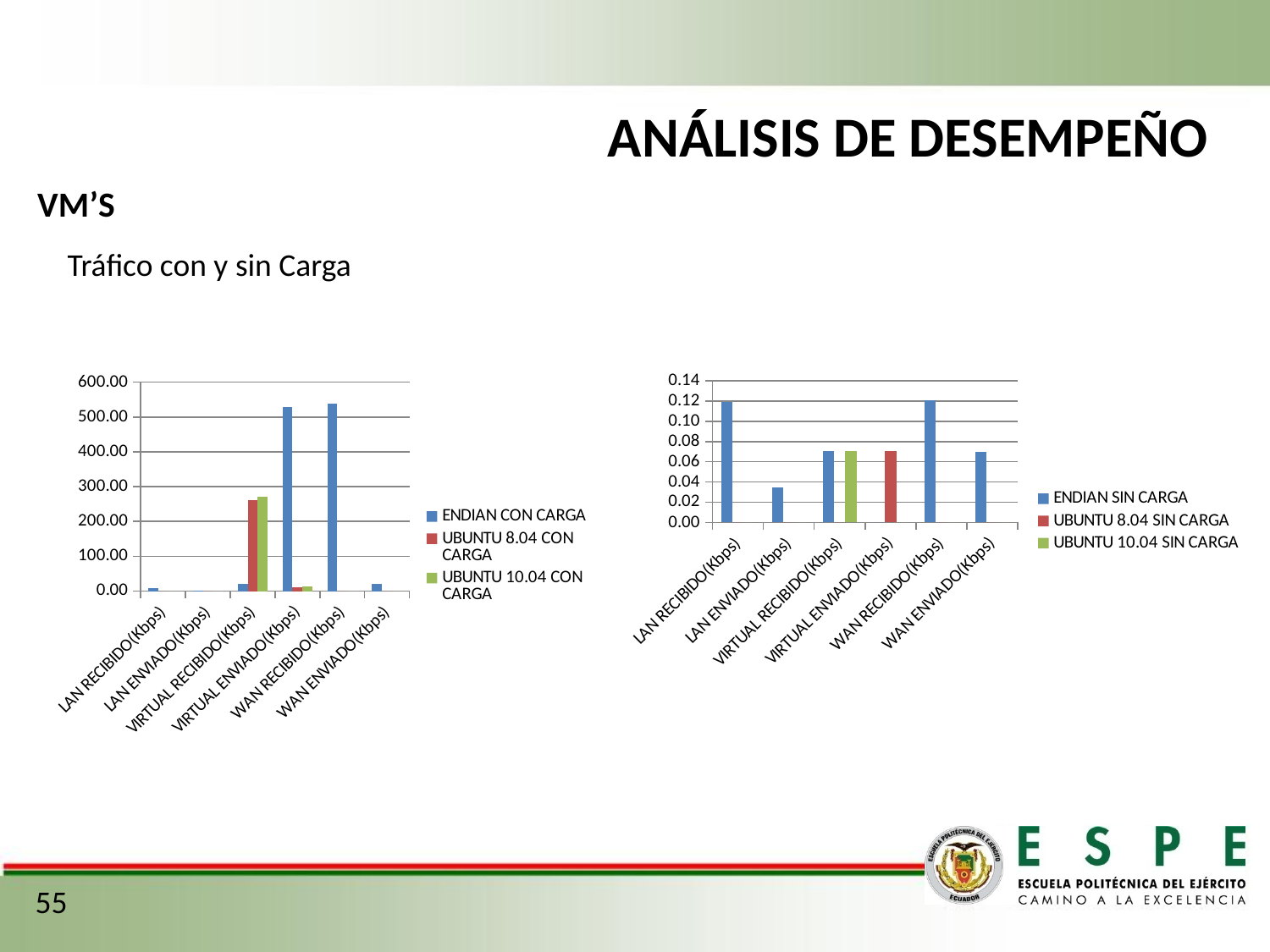
What kind of chart is the left chart on the slide? bar chart In the left chart, for VIRTUAL RECIBIDO(Kbps), which is larger: ENDIAN CON CARGA or UBUNTU 10.04 CON CARGA? UBUNTU 10.04 CON CARGA How many series does the legend of the right chart list? 3 In the right chart, is the UBUNTU 8.04 SIN CARGA value for VIRTUAL ENVIADO(Kbps) greater or less than 0.06? greater In the left chart, is the value of ENDIAN CON CARGA for WAN RECIBIDO(Kbps) greater or less than 500.00? greater In the right chart, which series is shown in green in the legend? UBUNTU 10.04 SIN CARGA In the left chart, which category has the highest ENDIAN CON CARGA value? WAN RECIBIDO(Kbps) How many categories are shown on the x axis of the left chart? 6 In the right chart, is the ENDIAN SIN CARGA value for LAN ENVIADO(Kbps) greater or less than 0.04? less In the right chart, which is larger for ENDIAN SIN CARGA: WAN RECIBIDO(Kbps) or WAN ENVIADO(Kbps)? WAN RECIBIDO(Kbps)